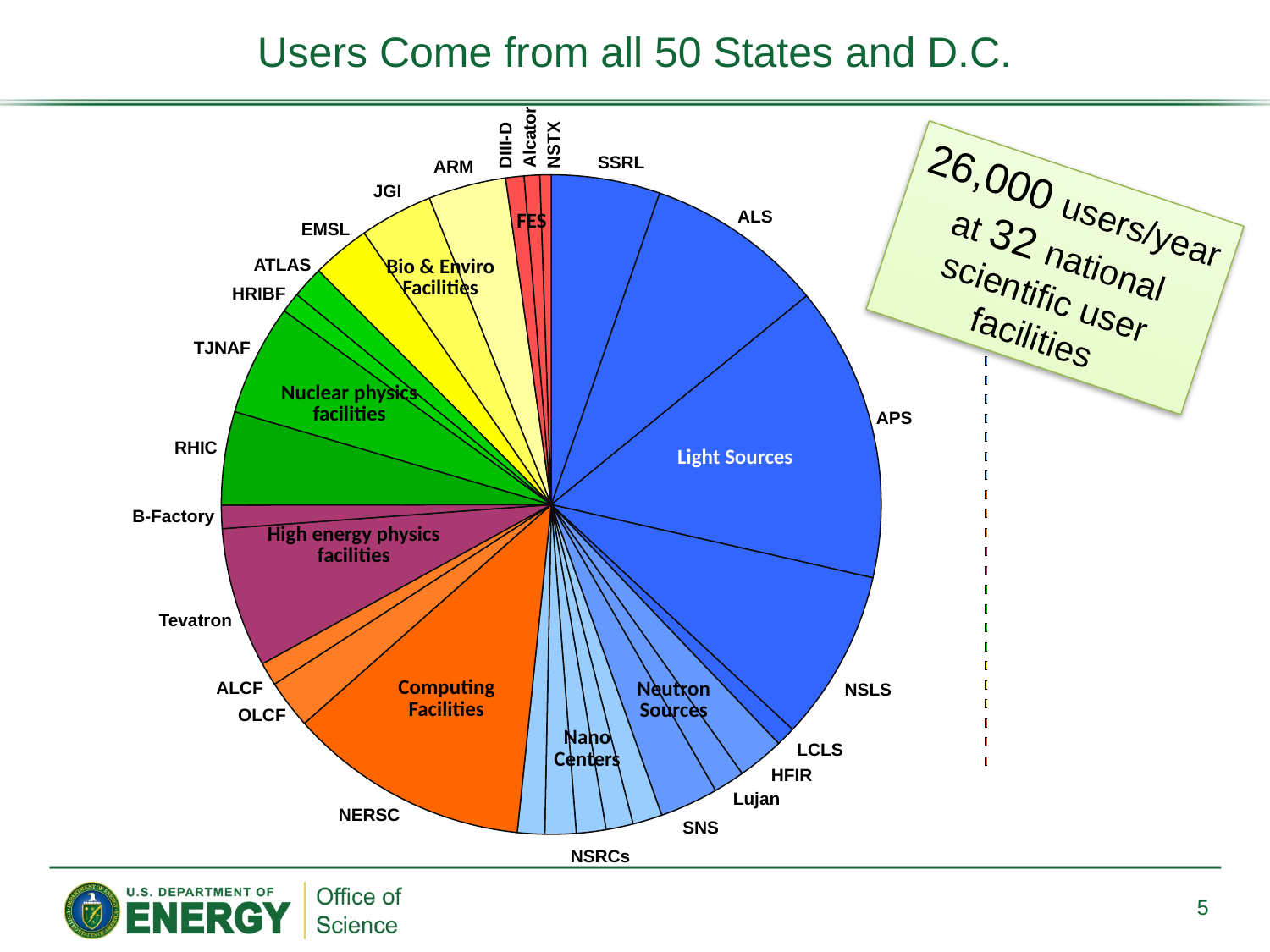
What kind of chart is shown on the slide? pie chart Which slice is larger, RHIC or HRIBF? RHIC According to the callout box, how many users per year are there at the national scientific user facilities? 26,000 users/year Which facility group is shown in orange? Computing Facilities Which facility group occupies the largest share of the pie? Light Sources Which slice is larger, Tevatron or B-Factory? Tevatron Which individual facility has the largest slice of the pie? APS How many facility groups are labelled on the pie chart? 8 Which slice is larger, APS or NERSC? APS